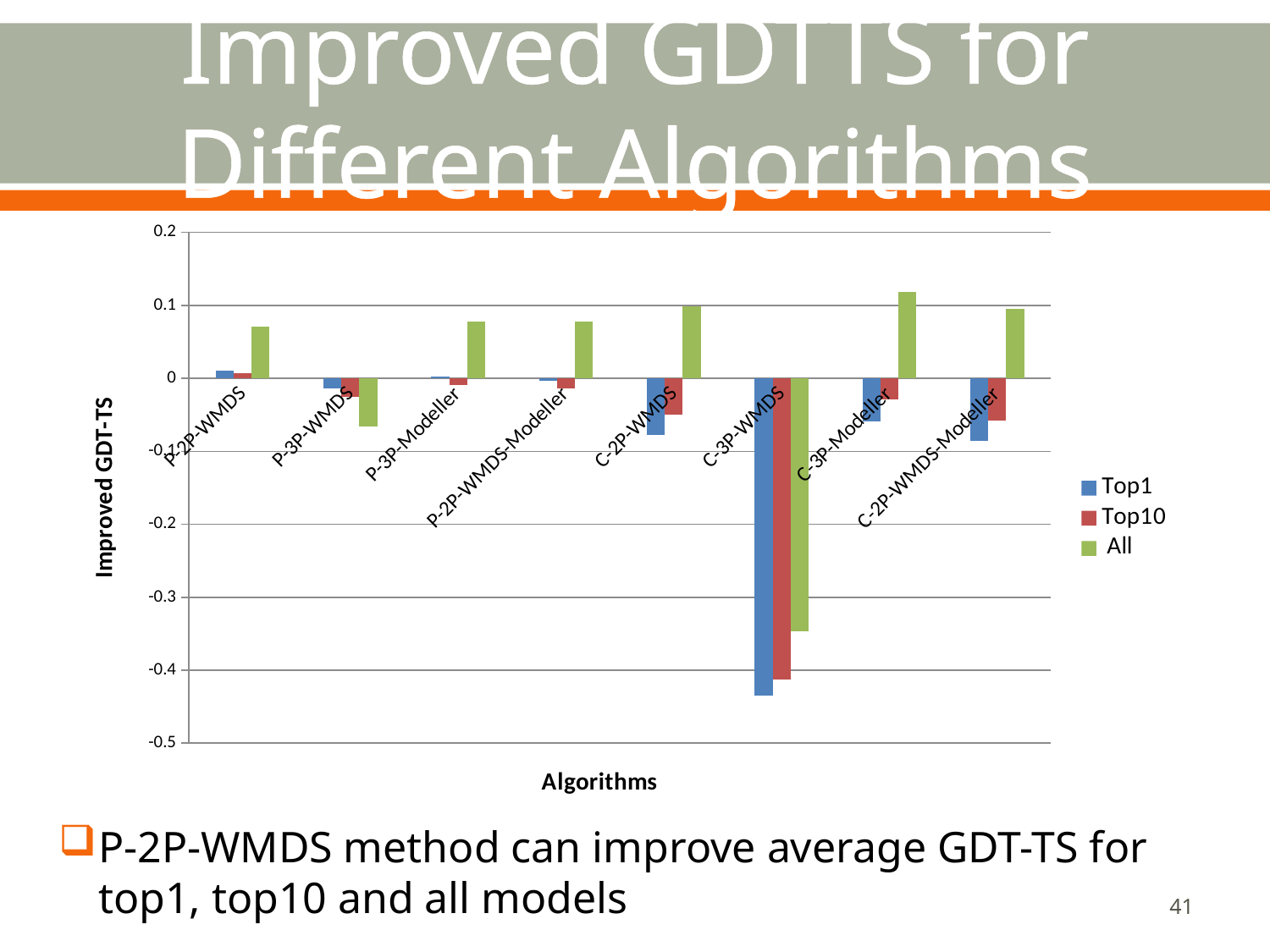
What kind of chart is shown on the slide? bar chart Is the All value for C-3P-Modeller greater or less than 0.1? greater Which is larger, the Top1 value for C-2P-WMDS or the Top1 value for C-3P-WMDS? C-2P-WMDS Which algorithm has the highest value for the All series? C-3P-Modeller Is the All value for C-3P-WMDS greater or less than -0.3? less What is the title of the y axis? Improved GDT-TS Is the Top1 value for C-3P-WMDS greater or less than -0.4? less Which series are listed in the legend? Top1, Top10, All Which is larger, the All value for P-2P-WMDS or the All value for P-3P-WMDS? P-2P-WMDS How many algorithms (categories) are plotted on the x axis? 8 How many series does the legend list? 3 Which algorithm has the lowest Top1 value? C-3P-WMDS